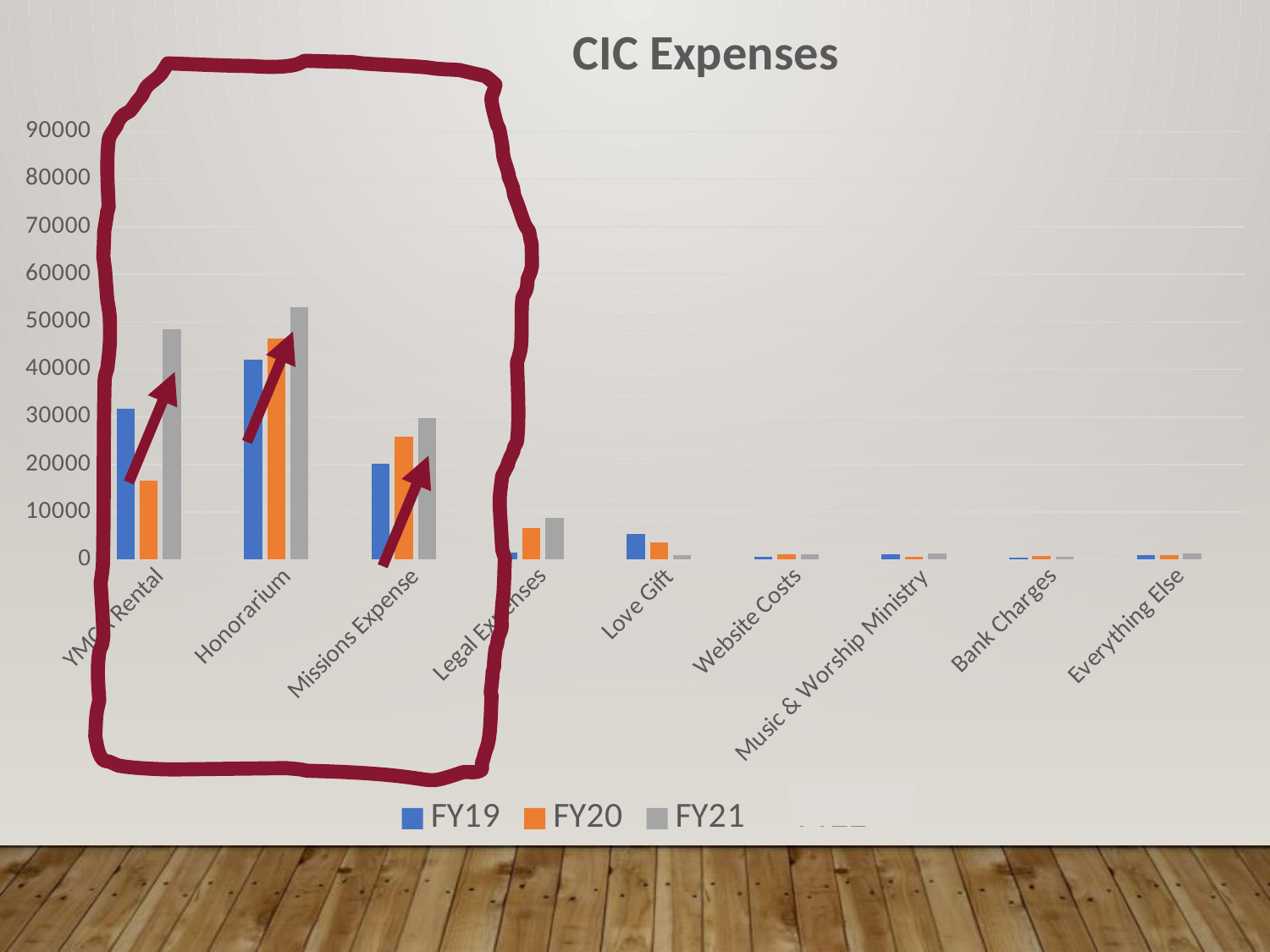
What kind of chart is shown on the slide? bar chart What is the title of the chart? CIC Expenses Which series are listed in the legend? FY19, FY20, FY21 Is the FY19 value for Honorarium greater or less than 30000? greater For Love Gift, which is larger: the FY19 value or the FY21 value? FY19 How many expense categories are shown on the x axis? 9 Is the FY21 value for Missions Expense greater or less than 20000? greater Is the FY21 value for Honorarium greater or less than 50000? greater How many series does the legend list? 3 Which category has the highest FY21 value? Honorarium Which is larger for FY21: Honorarium or Missions Expense? Honorarium Do the Honorarium values rise or fall from FY19 to FY21? rise